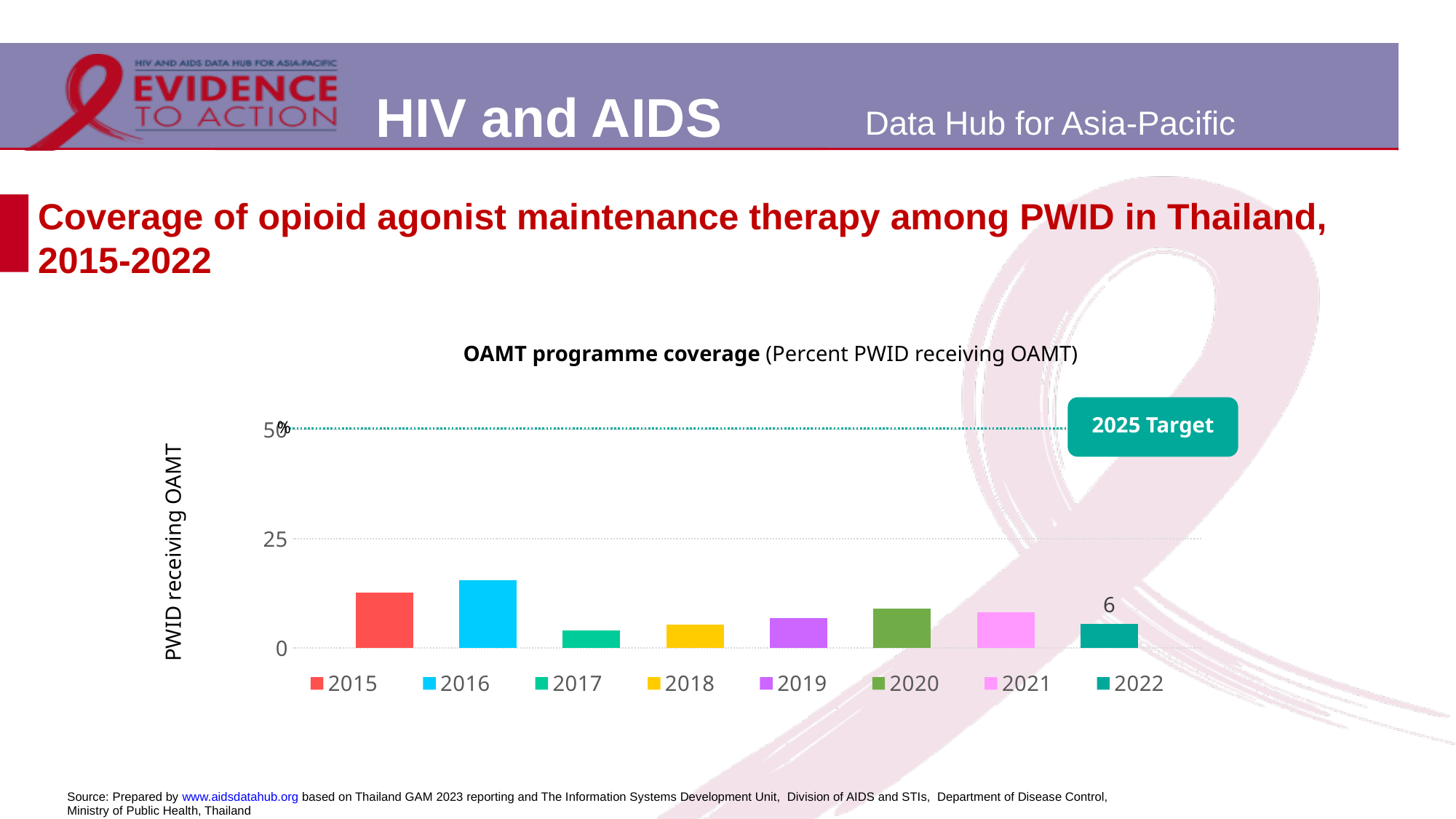
What is the title of the chart? OAMT programme coverage (Percent PWID receiving OAMT) Which year has the lowest OAMT programme coverage? 2017 How many entries does the legend list? 8 How many years are plotted in the chart? 8 What kind of chart is shown on the slide? bar chart What is the value for 2022 in the OAMT programme coverage chart? 6 Is the value for 2015 greater or less than 25? less Is the value for 2016 greater or less than 25? less Which year has higher OAMT coverage, 2017 or 2020? 2020 Which year has the highest OAMT programme coverage? 2016 Which year has higher OAMT coverage, 2015 or 2016? 2016 At what value is the 2025 Target line drawn? 50%